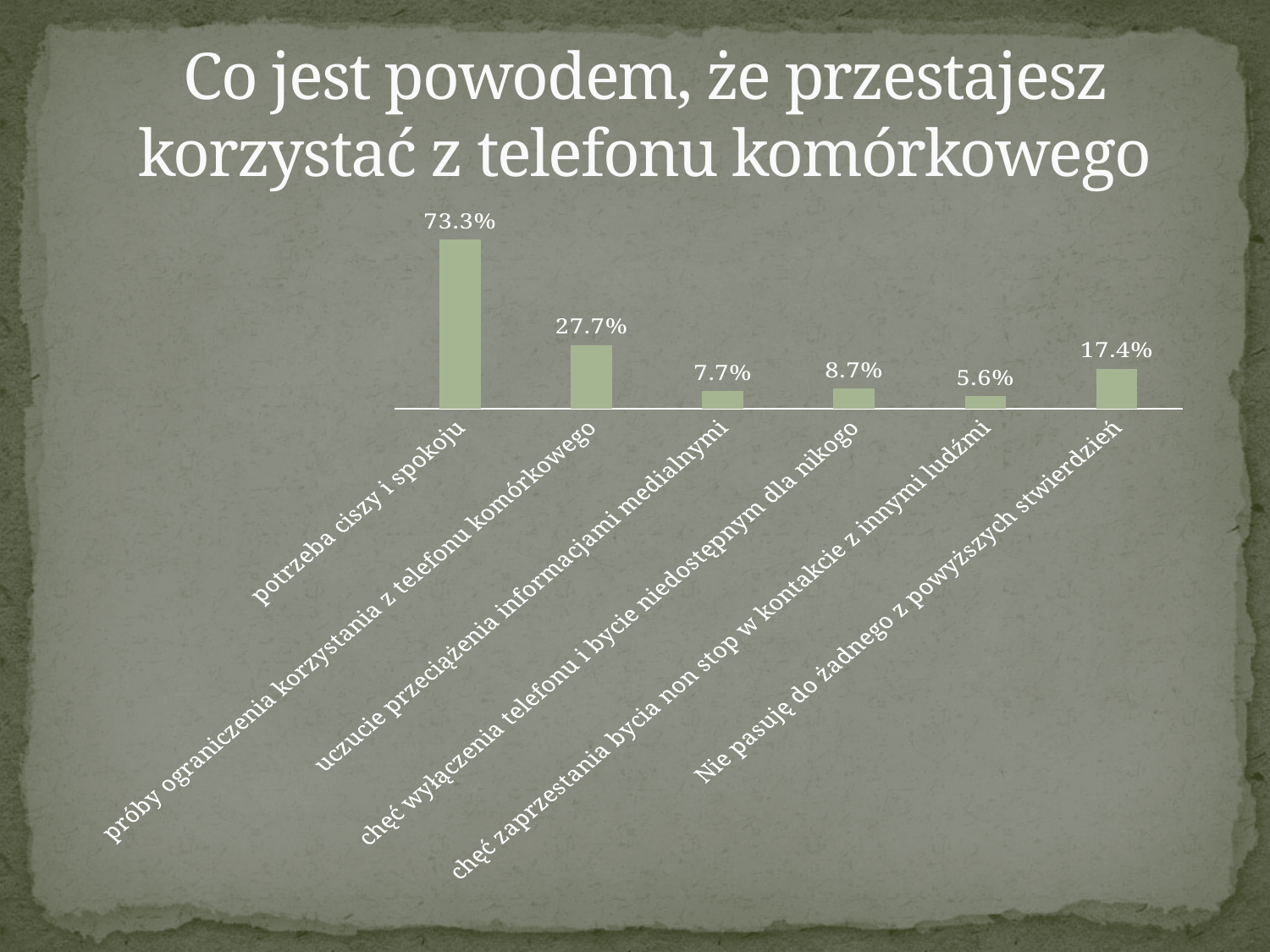
What is the title of the slide? Co jest powodem, że przestajesz korzystać z telefonu komórkowego What is the value for "Nie pasuję do żadnego z powyższych stwierdzień"? 17.4% What is the value for "potrzeba ciszy i spokoju"? 73.3% What is the difference between the values for "chęć wyłączenia telefonu i bycie niedostępnym dla nikogo" and "uczucie przeciążenia informacjami medialnymi"? 1.0% What is the value for "próby ograniczenia korzystania z telefonu komórkowego"? 27.7% Which category has the highest value? potrzeba ciszy i spokoju Which category has the lowest value? chęć zaprzestania bycia non stop w kontakcie z innymi ludźmi Which is larger, the value for "Nie pasuję do żadnego z powyższych stwierdzień" or the value for "chęć wyłączenia telefonu i bycie niedostępnym dla nikogo"? Nie pasuję do żadnego z powyższych stwierdzień What kind of chart is shown on the slide? bar chart What is the difference between the values for "potrzeba ciszy i spokoju" and "próby ograniczenia korzystania z telefonu komórkowego"? 45.6% What is the value for "uczucie przeciążenia informacjami medialnymi"? 7.7% How many categories are shown in the chart? 6